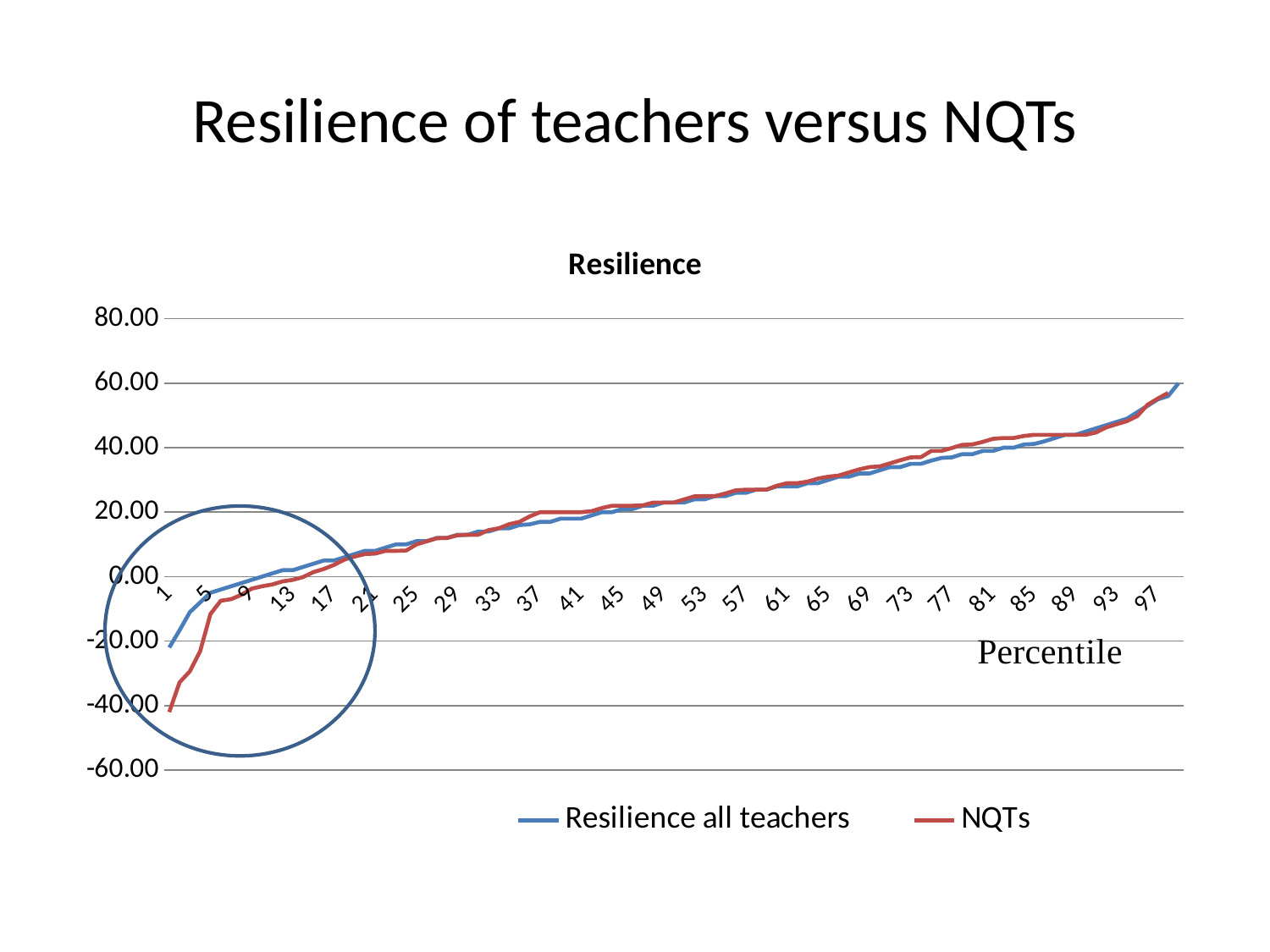
How many series does the legend list? 2 What label is given to the x axis of the chart? Percentile Do the values of the NQTs series rise or fall as the percentile increases along the x axis? rise Is the value for NQTs at percentile 1 greater or less than -20.00? less What kind of chart is shown on the slide? line chart At percentile 1, which series has the higher value, Resilience all teachers or NQTs? Resilience all teachers Do the values of the Resilience all teachers series rise or fall along the x axis? rise What is the title of the chart? Resilience Is the value for Resilience all teachers at percentile 1 greater or less than 0.00? less At which percentile is the NQTs series at its lowest value? 1 At percentile 5, which series has the lower value, Resilience all teachers or NQTs? NQTs Is the value for NQTs at percentile 97 greater or less than 40.00? greater